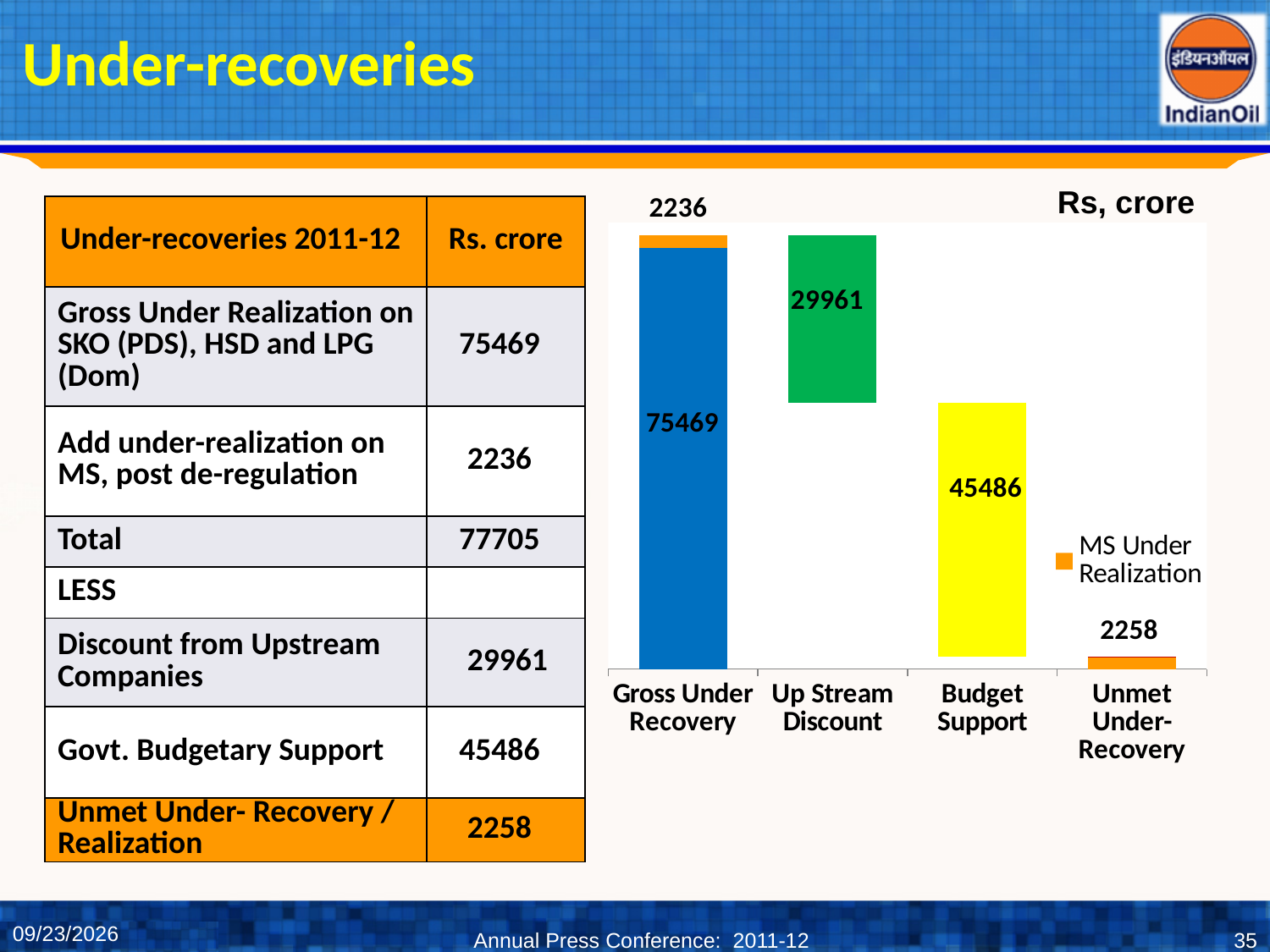
What is the total of the stacked Gross Under Recovery bar (75469 plus 2236)? 77705 Which is larger, the Budget Support bar or the Up Stream Discount bar? Budget Support Which category has the tallest bar in the chart? Gross Under Recovery What is the value labelled on the Budget Support bar? 45486 What unit is stated at the top right of the chart? Rs, crore How many categories are shown on the x axis of the chart? 4 What value is labelled above the orange segment on top of the Gross Under Recovery bar? 2236 What is the value labelled on the blue Gross Under Recovery bar? 75469 What is the value labelled on the Up Stream Discount bar? 29961 Which category has the smallest bar in the chart? Unmet Under-Recovery What is the difference between the Budget Support value and the Up Stream Discount value? 15525 What is the value labelled for Unmet Under-Recovery? 2258